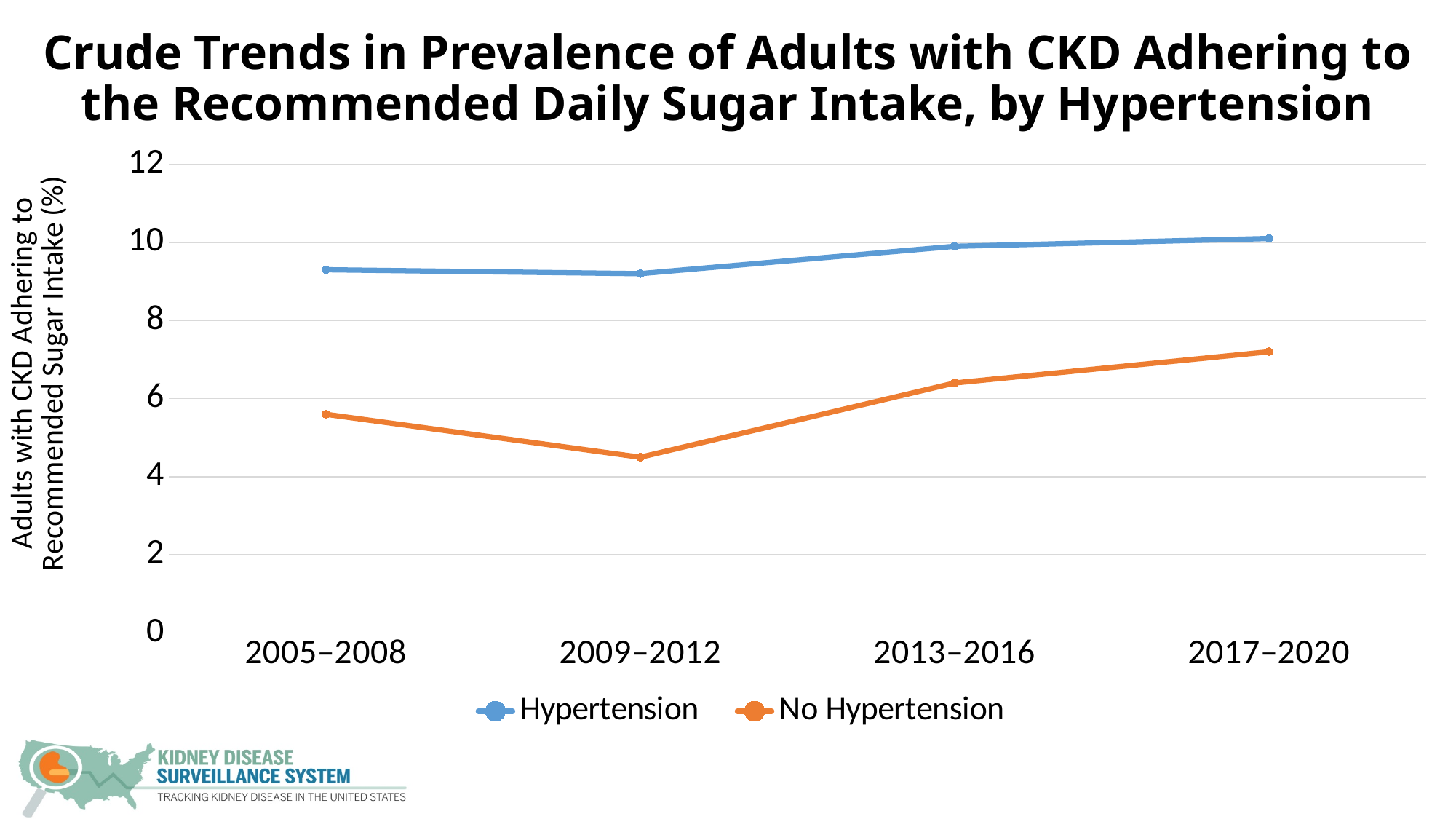
What is the label of the y axis? Adults with CKD Adhering to Recommended Sugar Intake (%) What colour is the line for No Hypertension? orange How many series does the legend list? 2 Does the No Hypertension series rise or fall from 2009–2012 to 2017–2020? rise What kind of chart is shown on the slide? line chart In which time period is the No Hypertension series at its lowest? 2009–2012 Is the value for Hypertension in 2017–2020 greater or less than 8? greater Is the value for No Hypertension in 2009–2012 greater or less than 6? less In which time period is the Hypertension series at its highest? 2017–2020 Which series has the higher value in 2017–2020, Hypertension or No Hypertension? Hypertension Is the value for No Hypertension in 2017–2020 greater or less than 8? less How many time periods are shown on the x axis? 4